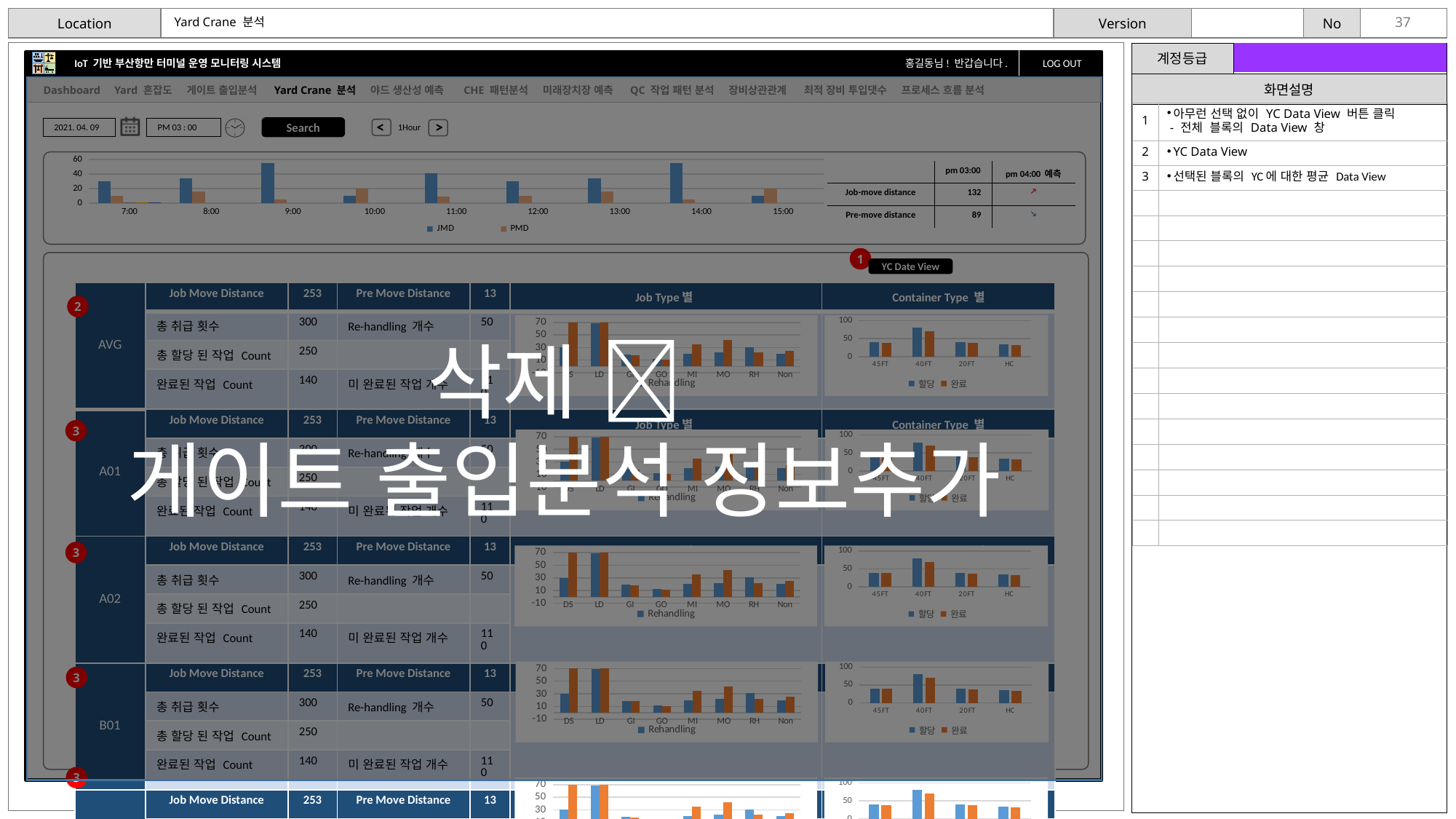
In the Container Type 별 chart in the A02 row, which category has the highest 할당 bar? 40FT How many categories are on the x axis of the Container Type 별 chart in the A02 row? 4 How many time categories are shown on the x axis of the top JMD/PMD chart? 9 What kind of chart is the JMD/PMD chart at the top of the screen? bar chart In the top JMD/PMD chart, is the JMD value at 9:00 greater or less than 40? greater How many categories are on the x axis of the Job Type 별 chart in the A02 row? 8 In the top JMD/PMD chart, which series is larger at 10:00, JMD or PMD? PMD How many series does the legend of the top JMD/PMD chart list? 2 In the Container Type 별 chart in the A02 row, is the 할당 value for 45FT greater or less than 50? less In the top JMD/PMD chart, which series is larger at 7:00, JMD or PMD? JMD In the top JMD/PMD chart, is the PMD value at 9:00 greater or less than 20? less In the Job Type 별 chart in the A02 row, which category has the lowest bars? GO